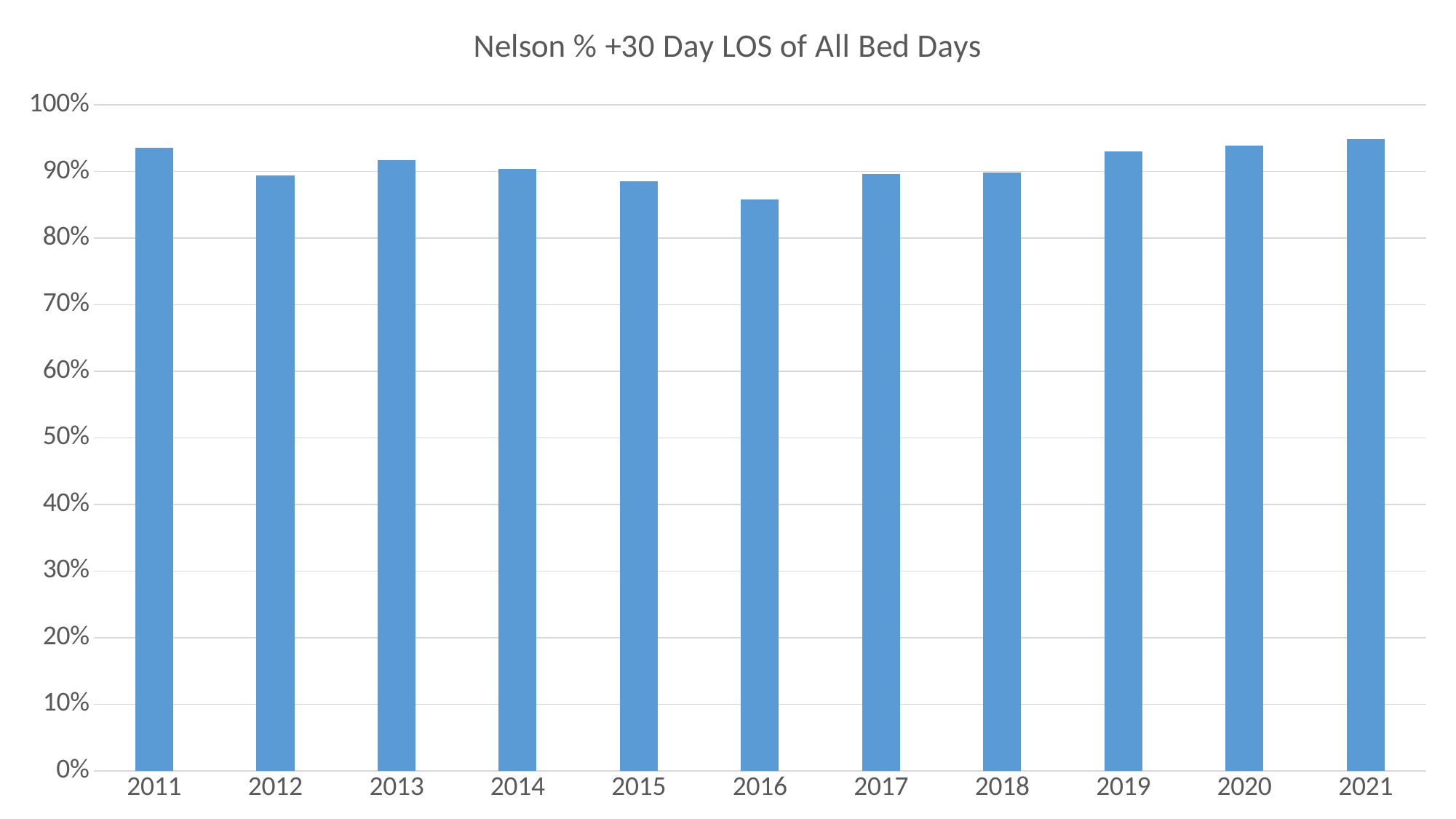
Is the value for 2019 greater or less than 90%? greater Is the value for 2015 greater or less than 90%? less What kind of chart is shown on the slide? bar chart Which year has the larger value, 2011 or 2016? 2011 Which year has the larger value, 2013 or 2015? 2013 What is the title of the chart? Nelson % +30 Day LOS of All Bed Days How many years are shown on the x axis of the chart? 11 Which year has the highest value in the chart? 2021 From 2016 to 2021, do the values rise or fall? rise Is the value for 2011 greater or less than 90%? greater Which year has the lowest value in the chart? 2016